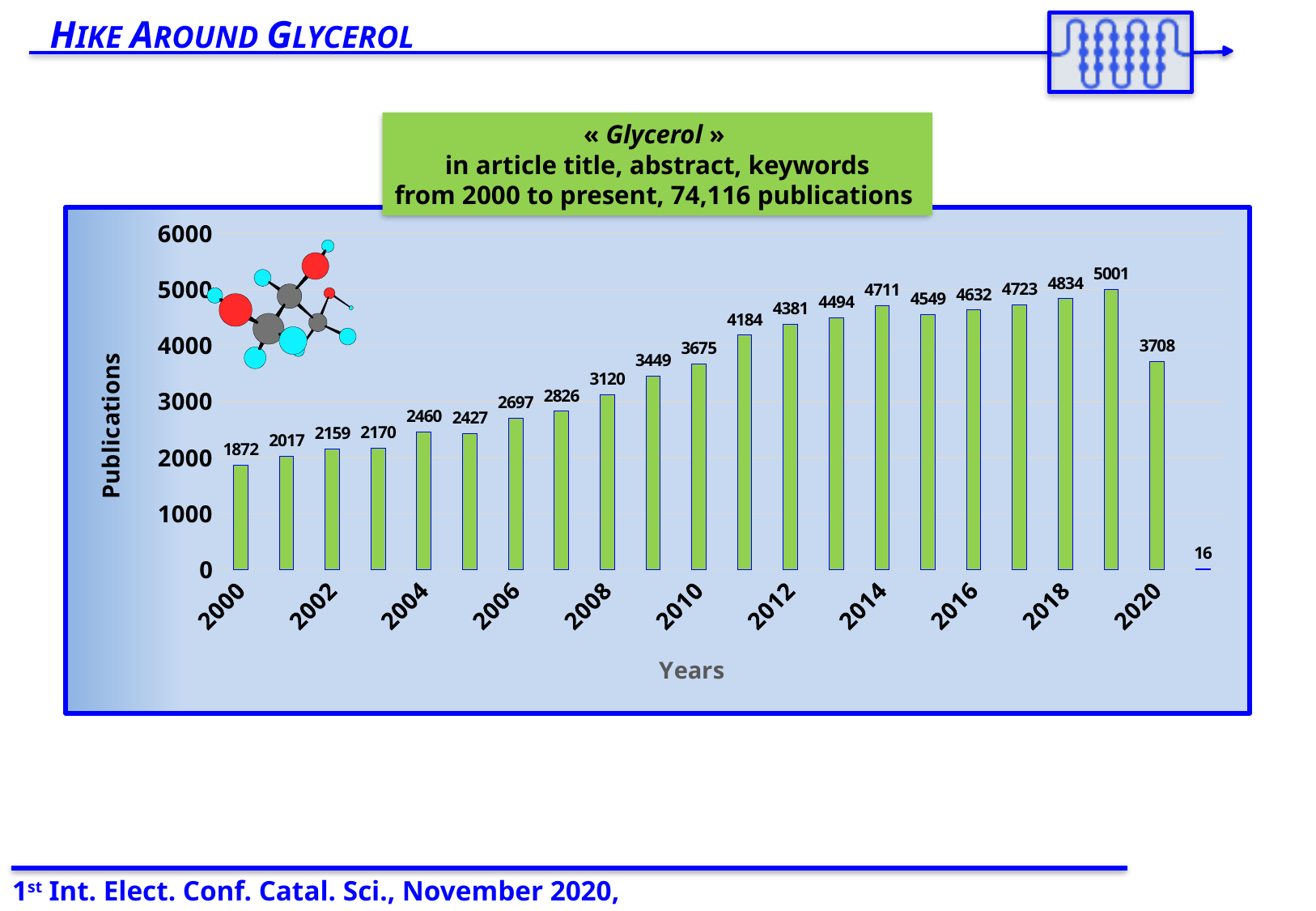
How many publications are shown for the year 2010? 3675 How many publications are shown for the year 2000? 1872 Is the value for 2008 greater or less than 3000? greater How many publications are shown for the year 2020? 3708 What is the lowest number of publications labelled on any bar in the chart? 16 Do the publication counts generally rise or fall from 2000 to 2019? rise What is the label of the vertical axis of the chart? Publications What type of chart is shown on the slide? bar chart How many bars are plotted in the chart? 22 Which year has more publications, 2012 or 2014? 2014 What is the difference in publications between 2018 and 2016? 202 What is the highest number of publications labelled on any bar in the chart? 5001